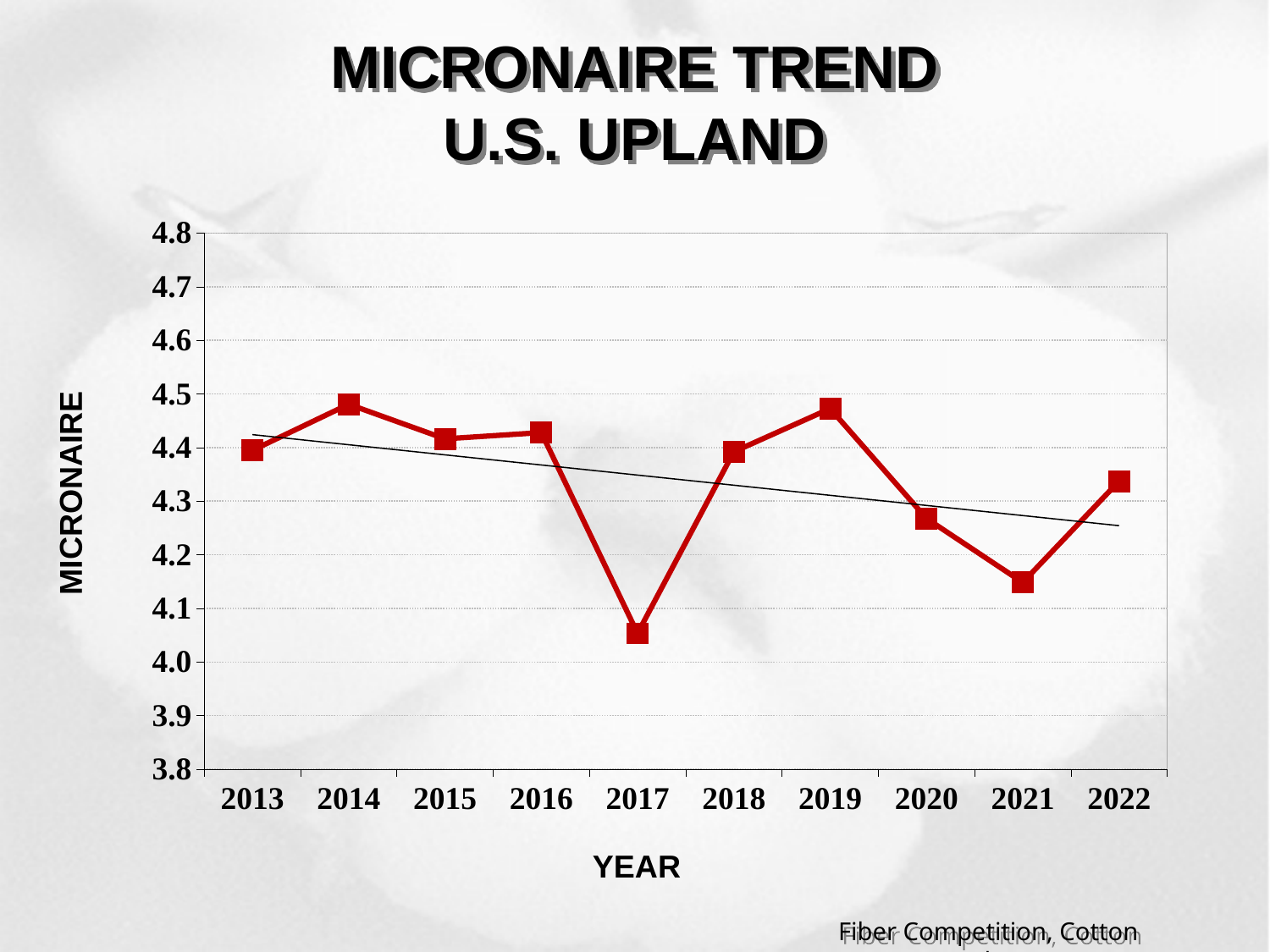
Does the straight trend line drawn through the data rise or fall from 2013 to 2022? Fall Which year has the lowest micronaire value? 2017 What kind of chart is shown on the slide? Line chart What is the label on the vertical axis of the chart? MICRONAIRE Is the micronaire value for 2021 greater or less than 4.2? less Is the micronaire value for 2014 greater or less than 4.4? greater Which year has the higher micronaire value, 2014 or 2020? 2014 How many years are plotted on the x axis? 10 Is the micronaire value for 2022 greater or less than 4.3? greater Which year has the higher micronaire value, 2017 or 2021? 2021